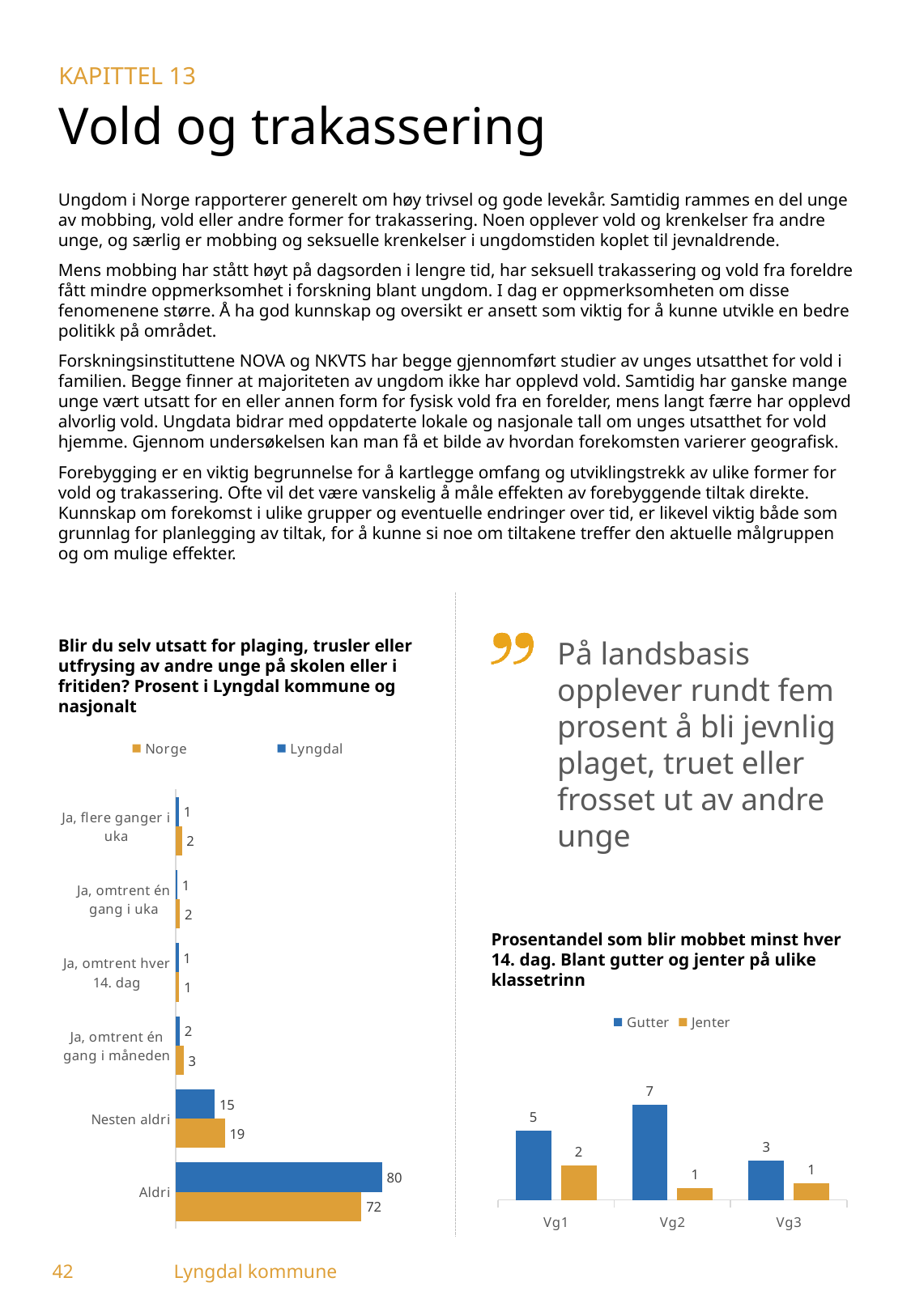
In the left chart (Blir du selv utsatt for plaging...), how many series does the legend list? 2 What kind of chart is the right chart (Prosentandel som blir mobbet minst hver 14. dag)? Bar chart In the left chart (Blir du selv utsatt for plaging...), what is the difference between Lyngdal and Norge for 'Aldri'? 8 In the right chart (Prosentandel som blir mobbet minst hver 14. dag), what is the difference between Gutter and Jenter at Vg2? 6 In the left chart (Blir du selv utsatt for plaging...), how many categories are shown? 6 In the right chart (Prosentandel som blir mobbet minst hver 14. dag), what is the value for Gutter at Vg2? 7 In the right chart (Prosentandel som blir mobbet minst hver 14. dag), what is the value for Jenter at Vg1? 2 In the right chart (Prosentandel som blir mobbet minst hver 14. dag), which class level has the highest value for Gutter? Vg2 In the left chart (Blir du selv utsatt for plaging...), what is the value for Lyngdal in the 'Aldri' category? 80 In the left chart (Blir du selv utsatt for plaging...), what is the value for Norge in the 'Nesten aldri' category? 19 In the left chart (Blir du selv utsatt for plaging...), which is larger for 'Nesten aldri': Norge or Lyngdal? Norge In the left chart (Blir du selv utsatt for plaging...), which category has the highest value for Lyngdal? Aldri